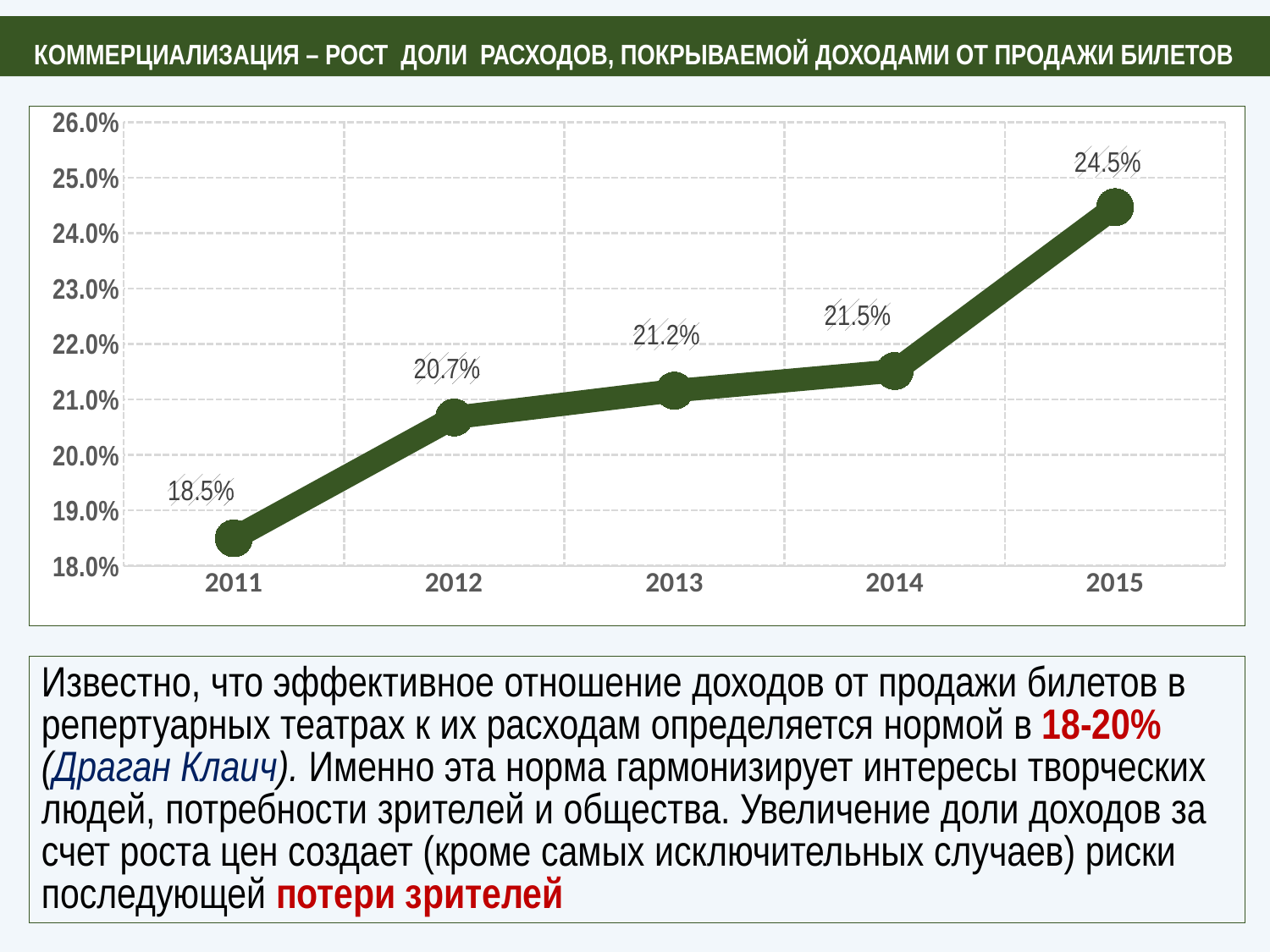
What is the value for 2015? 24.5% What is the value for 2011? 18.5% What is the value for 2013? 21.2% Which is larger, the value for 2013 or the value for 2014? 2014 How many years are plotted on the chart? 5 Which year has the lowest value? 2011 What kind of chart is shown on the slide? line chart Is the value for 2012 greater or less than 20.0%? greater Do the values rise or fall from 2011 to 2015? rise What is the difference between the values for 2015 and 2014? 3.0% Which year has the highest value? 2015 What is the difference between the values for 2012 and 2011? 2.2%